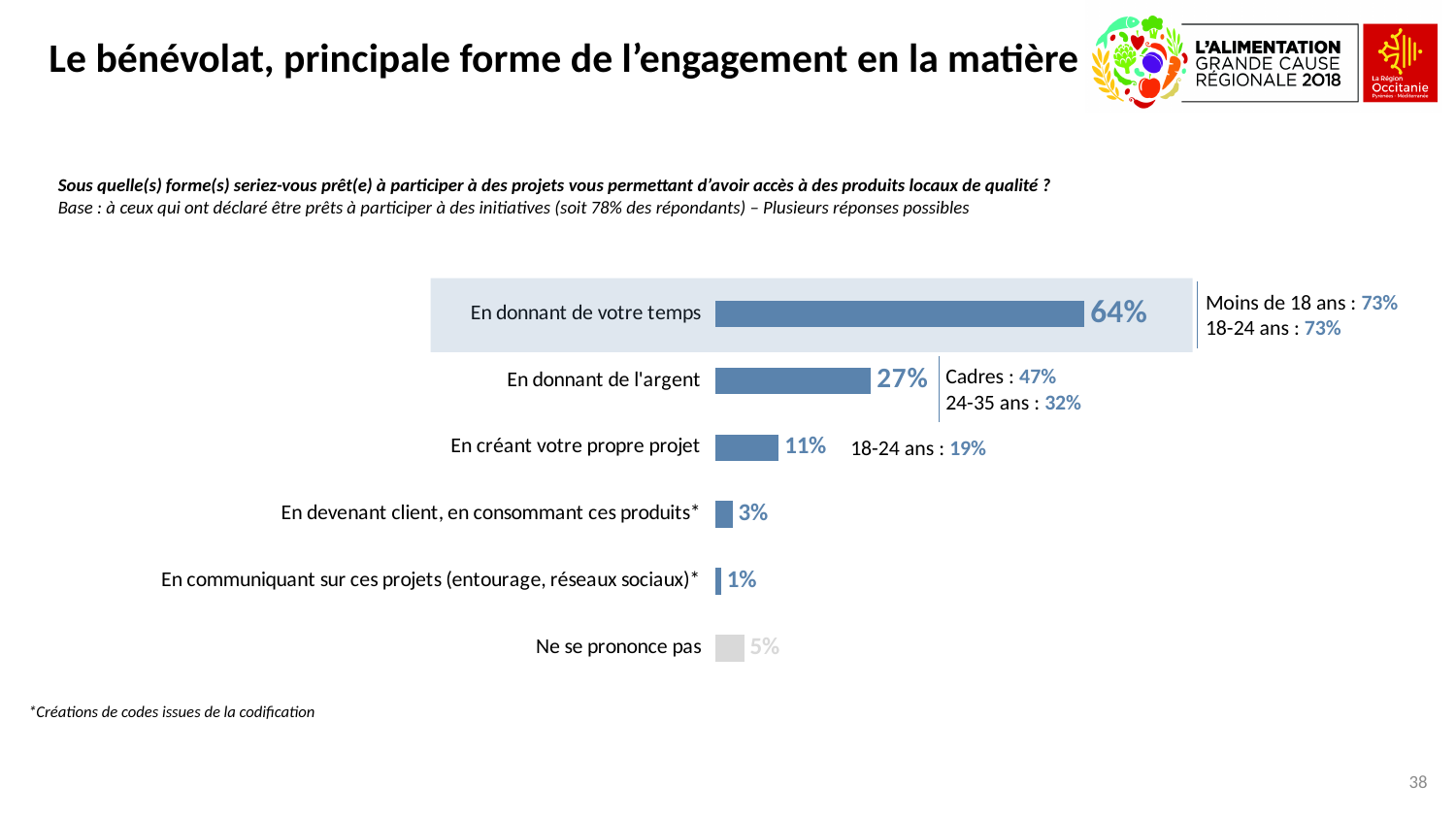
Which is larger: "En créant votre propre projet" or "En devenant client, en consommant ces produits*"? En créant votre propre projet What is the value for "Ne se prononce pas"? 5% What is the value for "En donnant de l'argent"? 27% What is the value for "En donnant de votre temps" among 18-24 ans, as annotated next to the bar? 73% Which category has the lowest value? En communiquant sur ces projets (entourage, réseaux sociaux)* What is the value for "En créant votre propre projet"? 11% What is the difference between "En donnant de votre temps" and "En donnant de l'argent"? 37 percentage points Which category has the highest value? En donnant de votre temps What is the value for "En donnant de l'argent" among Cadres, as annotated next to the bar? 47% How many categories are shown in the chart? 6 What is the value for "En donnant de votre temps"? 64% What kind of chart is shown on the slide? Bar chart